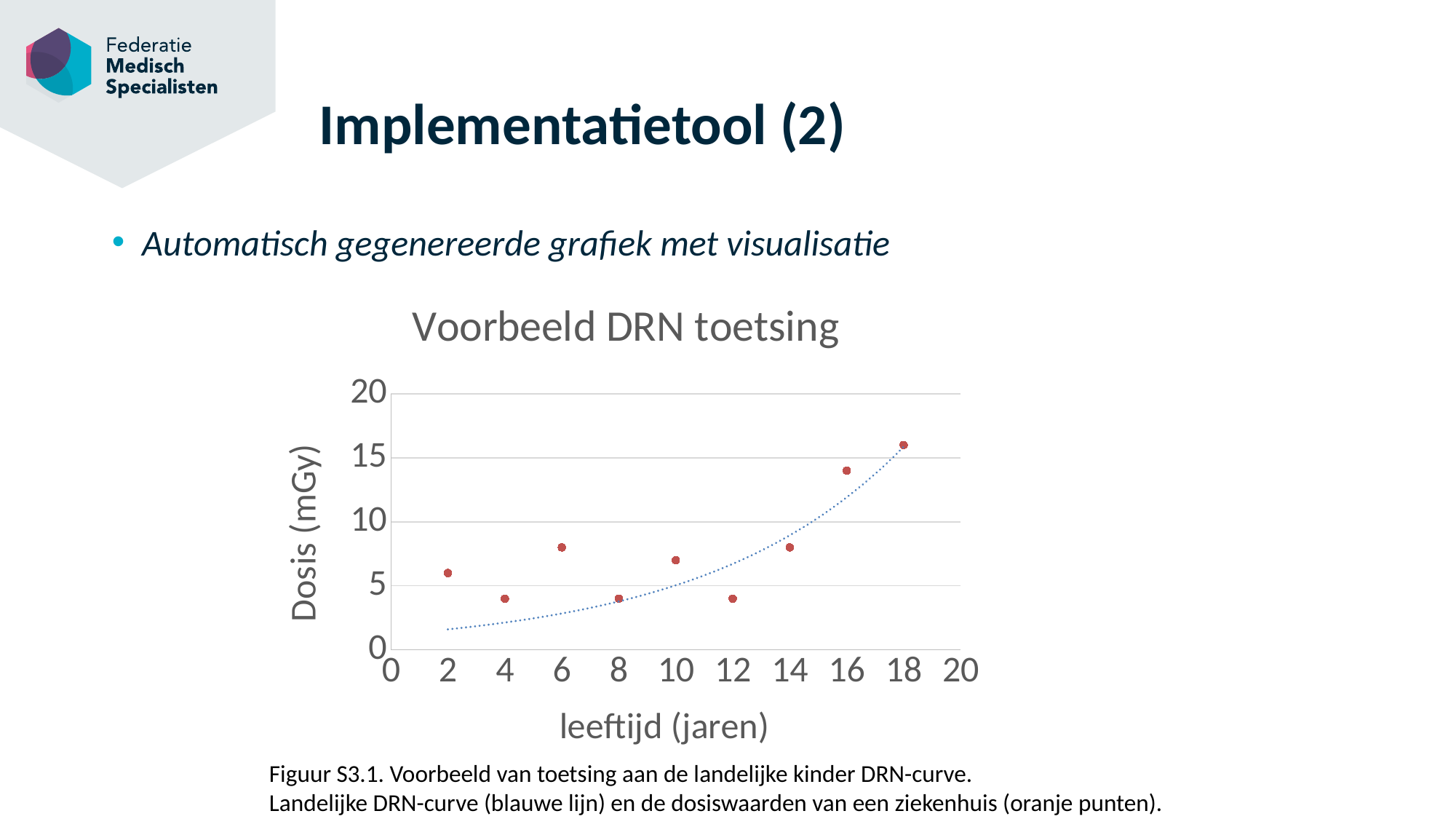
How many data points (oranje punten) are plotted in the chart? 9 What is the label of the vertical axis of the chart? Dosis (mGy) Is the dose value at age 14 greater or less than 10? less Which has the larger dose value: age 18 or age 2? age 18 Is the dose value at age 12 greater or less than 10? less What kind of chart is shown on the slide? scatter chart At which age (leeftijd) is the plotted dose value the highest? 18 Is the dose value at age 18 greater or less than 15? greater Does the dotted DRN curve rise or fall as age increases along the x axis? rise What is the title of the chart? Voorbeeld DRN toetsing